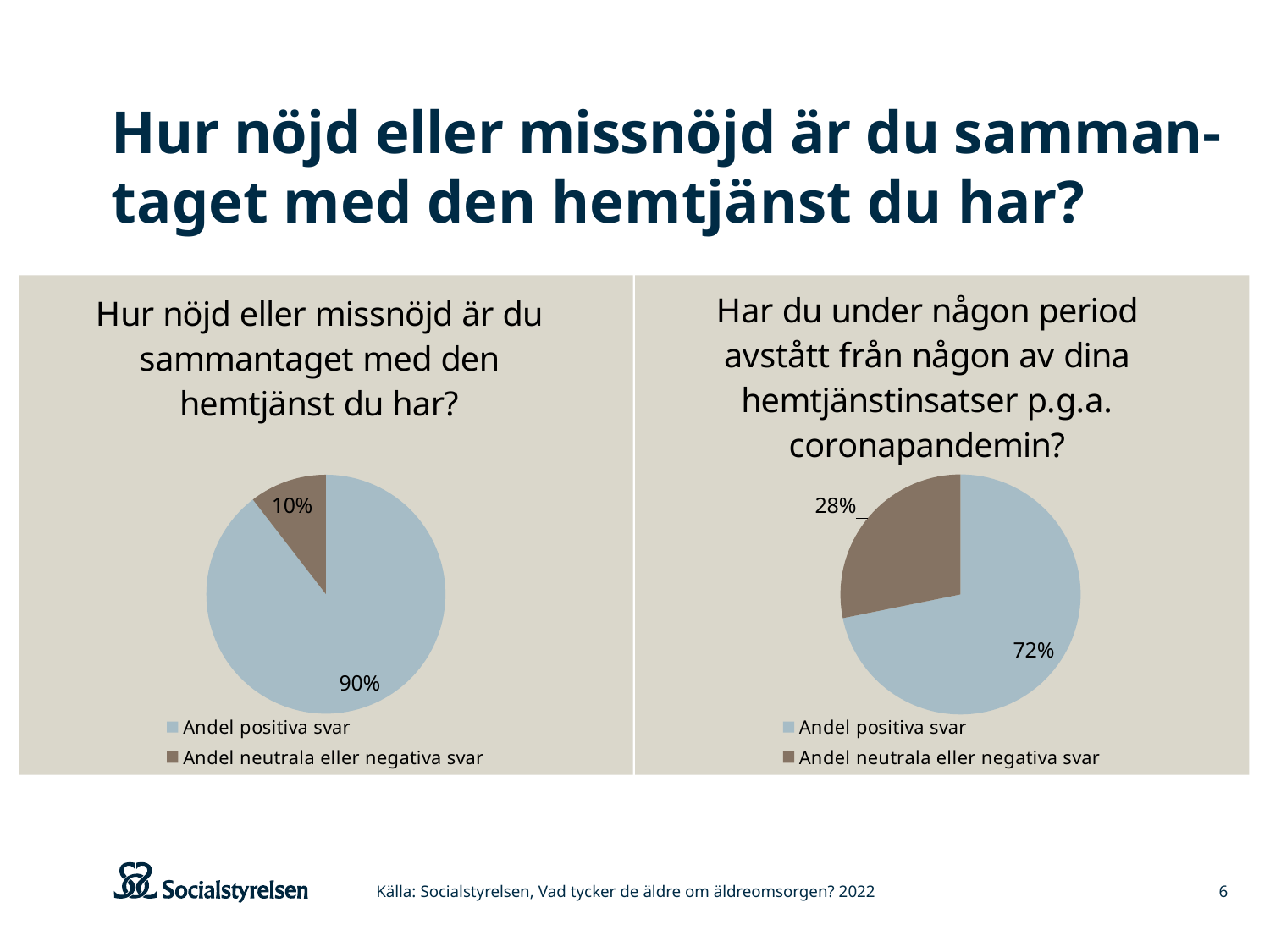
What type of chart is used on the left side of the slide? Pie chart In the left pie chart, which category has the largest share? Andel positiva svar In the left pie chart, what is the difference between "Andel positiva svar" and "Andel neutrala eller negativa svar"? 80% In the right pie chart, which category has the smallest share? Andel neutrala eller negativa svar In the right pie chart ("Har du under någon period avstått från någon av dina hemtjänstinsatser p.g.a. coronapandemin?"), what is the value for "Andel positiva svar"? 72% How many entries does the legend of the left pie chart list? 2 In the right pie chart, what is the difference between "Andel positiva svar" and "Andel neutrala eller negativa svar"? 44% In the left pie chart ("Hur nöjd eller missnöjd är du sammantaget med den hemtjänst du har?"), what is the value for "Andel positiva svar"? 90% How many slices does the right pie chart have? 2 In the left pie chart ("Hur nöjd eller missnöjd är du sammantaget med den hemtjänst du har?"), what is the value for "Andel neutrala eller negativa svar"? 10% In the right pie chart ("Har du under någon period avstått från någon av dina hemtjänstinsatser p.g.a. coronapandemin?"), what is the value for "Andel neutrala eller negativa svar"? 28% Which is larger: "Andel neutrala eller negativa svar" in the left pie chart or "Andel neutrala eller negativa svar" in the right pie chart? The right pie chart